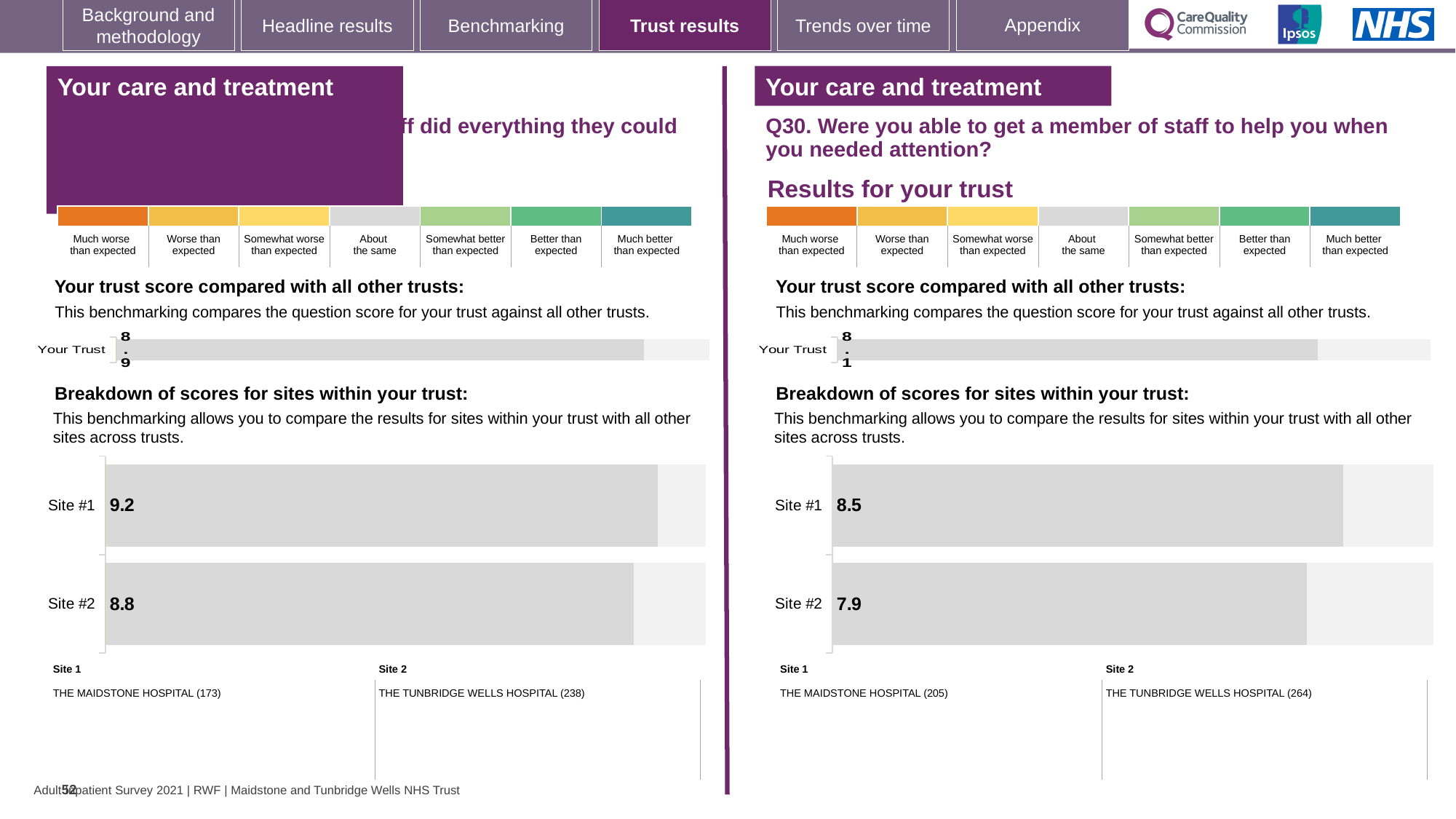
On the left half of the slide, in the 'Breakdown of scores for sites within your trust' chart, what is the score for Site #1? 9.2 In the Q30 'Breakdown of scores for sites within your trust' chart on the right half of the slide, what is the score for Site #1? 8.5 In the Q30 site breakdown chart on the right half of the slide, what is the difference between the Site #1 and Site #2 scores? 0.6 In the site breakdown chart on the left half of the slide, what is the difference between the Site #1 and Site #2 scores? 0.4 In the Q30 'Your trust score compared with all other trusts' chart on the right half of the slide, what is the 'Your Trust' score? 8.1 On the left half of the slide, what is the 'Your Trust' score shown in the 'Your trust score compared with all other trusts' chart? 8.9 In the Q30 site breakdown chart on the right half of the slide, which site has the higher score? Site #1 On the left half of the slide, in the 'Breakdown of scores for sites within your trust' chart, what is the score for Site #2? 8.8 In the site breakdown chart on the left half of the slide, which site has the lower score? Site #2 How many sites are shown in the Q30 site breakdown chart on the right half of the slide? 2 In the Q30 'Breakdown of scores for sites within your trust' chart on the right half of the slide, what is the score for Site #2? 7.9 What type of chart is used for the site breakdown on the left half of the slide? Bar chart